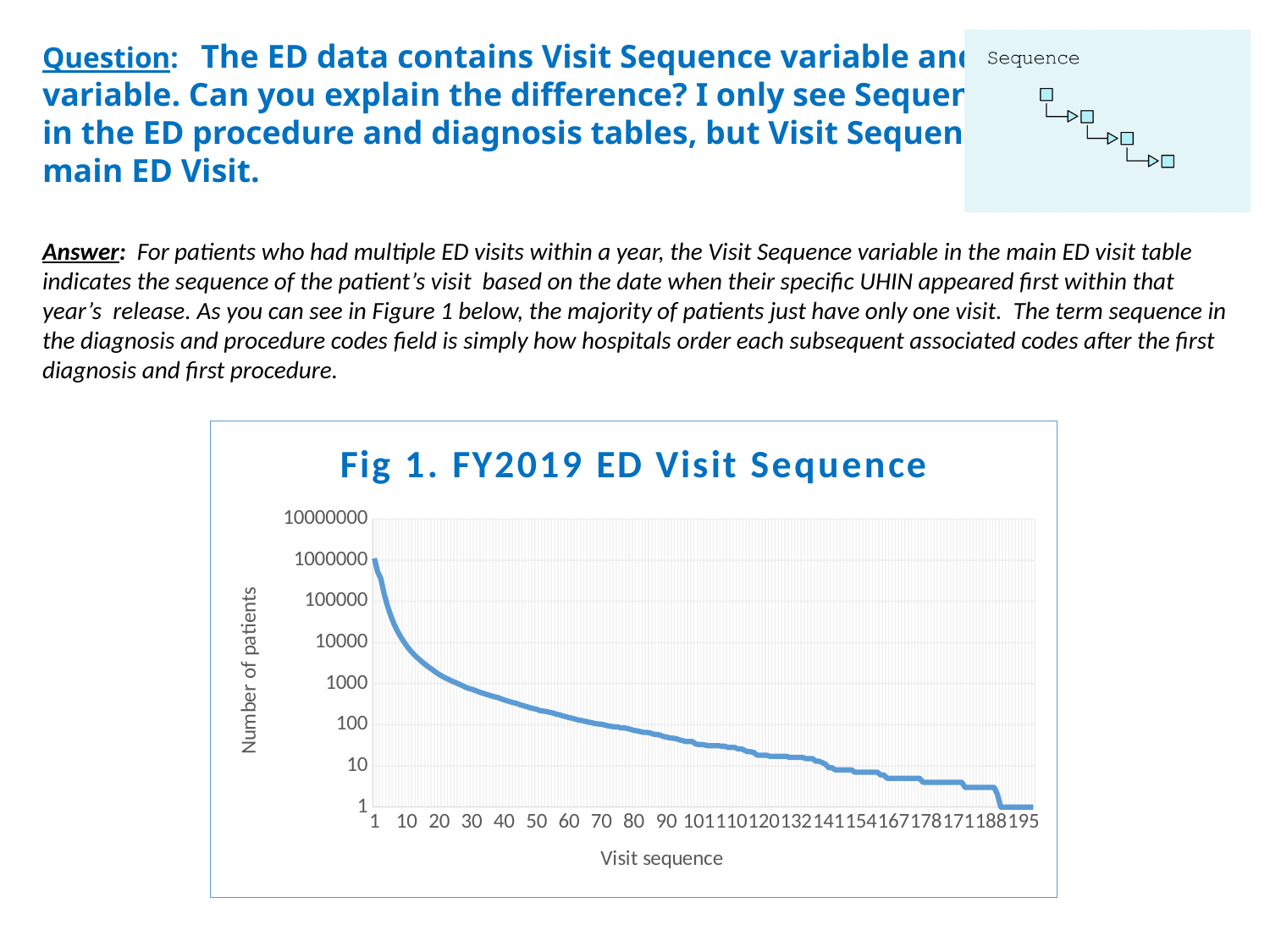
What is the title of the chart? Fig 1. FY2019 ED Visit Sequence What is the label of the vertical axis of the chart? Number of patients Which has more patients: visit sequence 10 or visit sequence 90? visit sequence 10 Is the number of patients at visit sequence 30 greater or less than 1000? less Do the values rise or fall as the visit sequence increases along the x axis? fall Is the number of patients at visit sequence 50 greater or less than 1000? less At which visit sequence is the number of patients highest? 1 Is the number of patients at visit sequence 1 greater or less than 100000? greater What kind of chart is shown on the slide? line chart